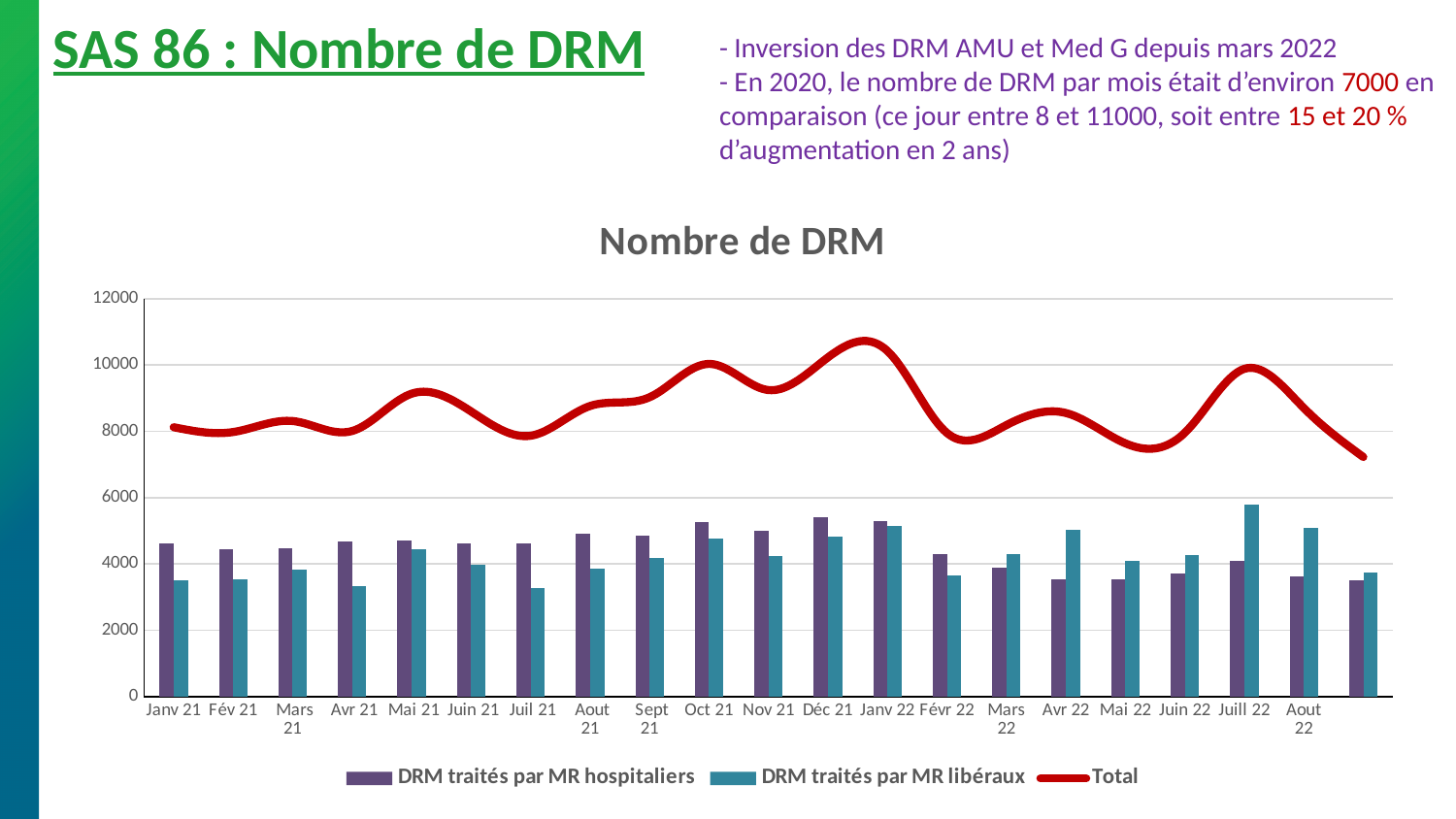
What kind of chart is shown on the slide? A combined bar and line chart Is the Total value for Aout 22 greater or less than 8000? greater Which series is drawn as a red line in the chart? Total Is the Total value for Janv 22 greater or less than 10000? greater Is the value for DRM traités par MR libéraux in Juill 22 greater or less than 4000? greater In Janv 21, which is larger: DRM traités par MR hospitaliers or DRM traités par MR libéraux? DRM traités par MR hospitaliers Does the Total line rise or fall from Juill 22 to Aout 22? Fall How many months are shown along the x axis of the chart? 20 In which month is the bar for DRM traités par MR libéraux the tallest? Juill 22 How many series does the chart legend list? 3 What is the title of the chart? Nombre de DRM In which month does the Total line reach its highest value? Janv 22